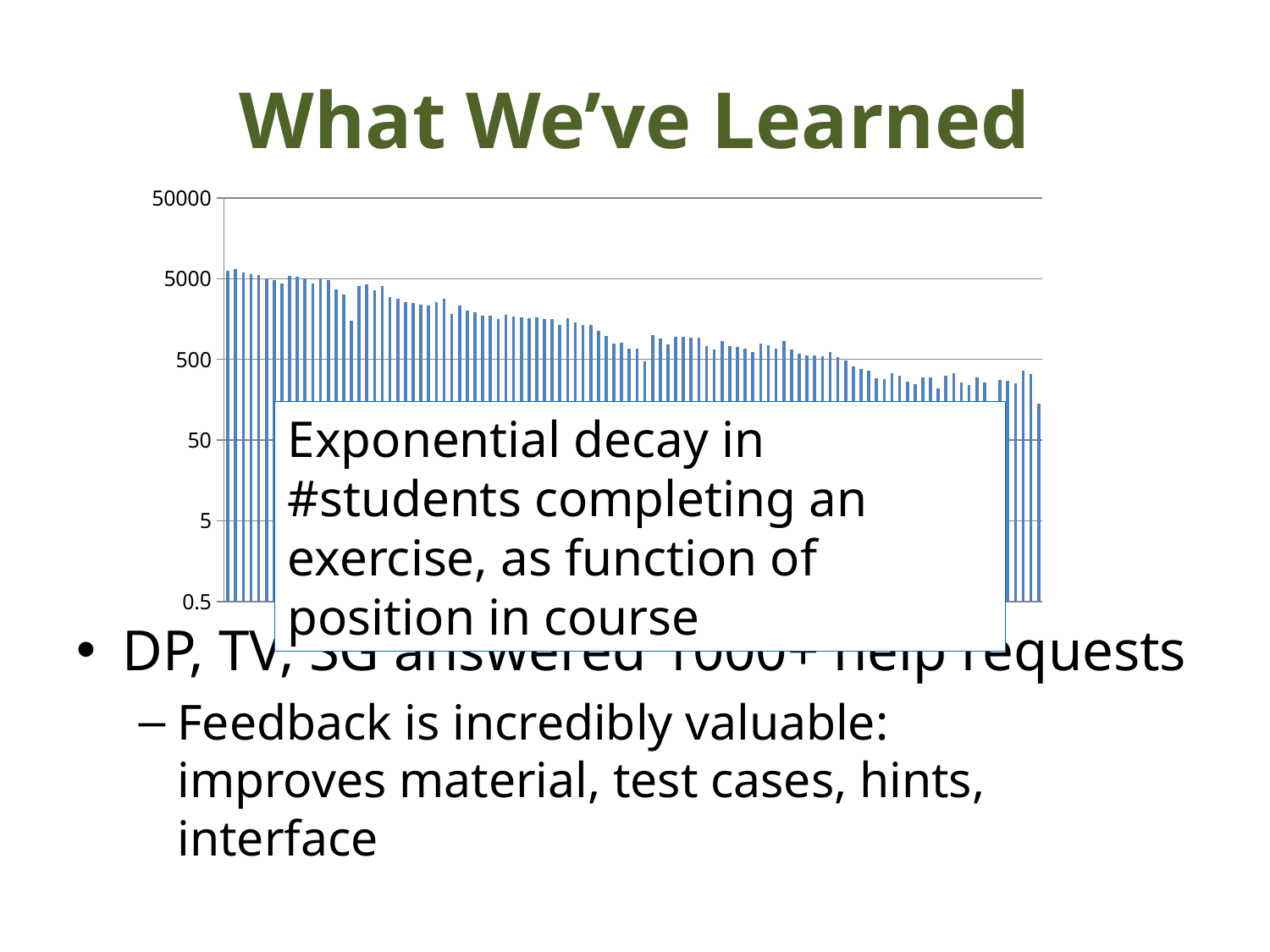
Is the value of the rightmost bar greater or less than 50? greater Is the value of the rightmost bar greater or less than 500? less Which is larger, the leftmost bar or the rightmost bar? the leftmost bar Are the shortest bars at the left end or the right end of the chart? right end Is the value of the leftmost bar greater or less than 50000? less What kind of chart is shown on the slide? bar chart Do the bar values generally rise or fall from left to right along the x axis? fall What is the highest tick label shown on the y axis? 50000 Is the y axis of the chart linear or logarithmic? logarithmic Are the tallest bars at the left end or the right end of the chart? left end